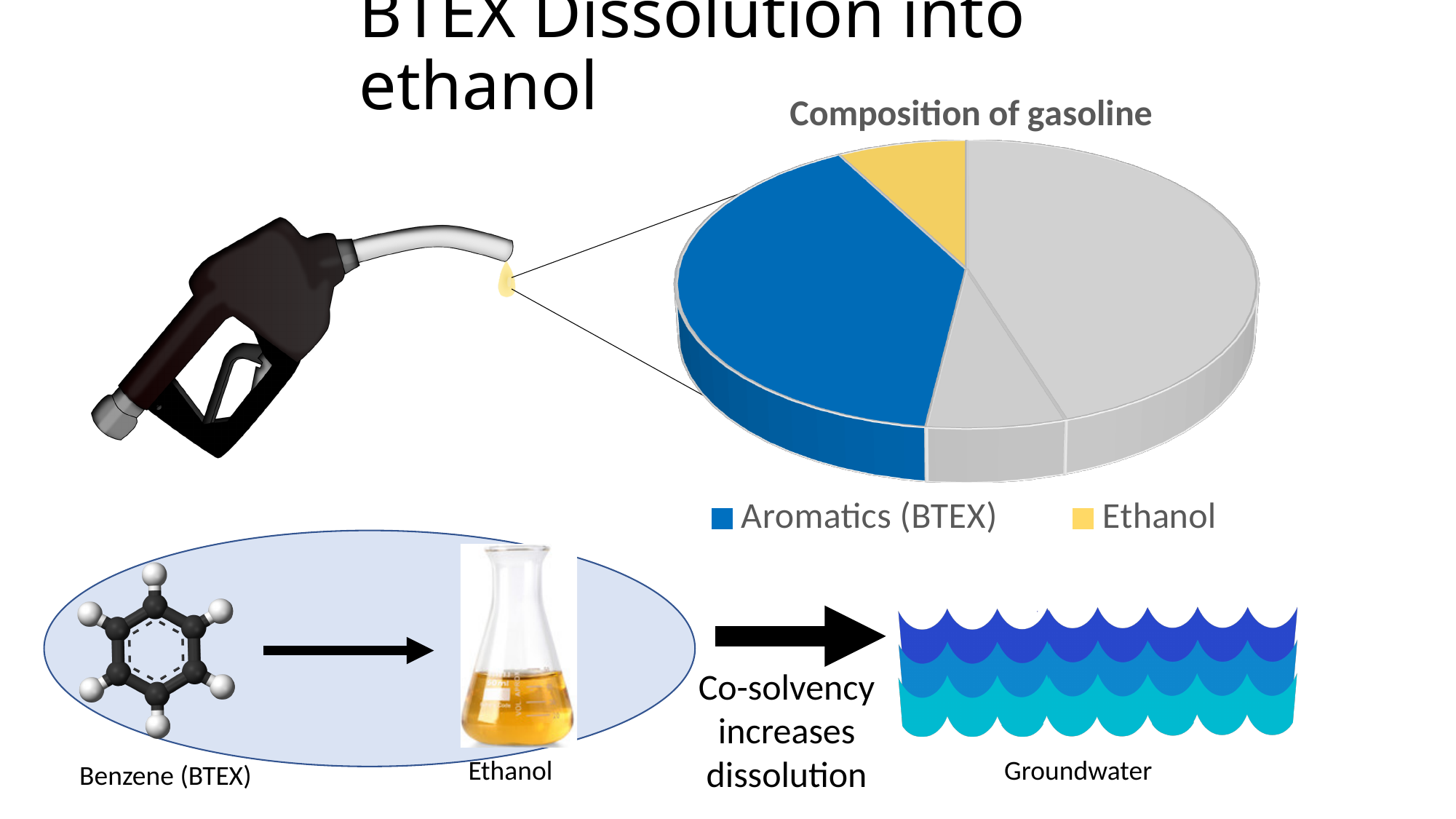
What is the title of the pie chart on the slide? Composition of gasoline In the "Composition of gasoline" pie chart, which slice is larger: Aromatics (BTEX) or Ethanol? Aromatics (BTEX) What kind of chart is shown under the title "Composition of gasoline"? pie chart How many entries does the legend of the "Composition of gasoline" pie chart list? 2 In the "Composition of gasoline" pie chart, what colour is the Ethanol slice? yellow